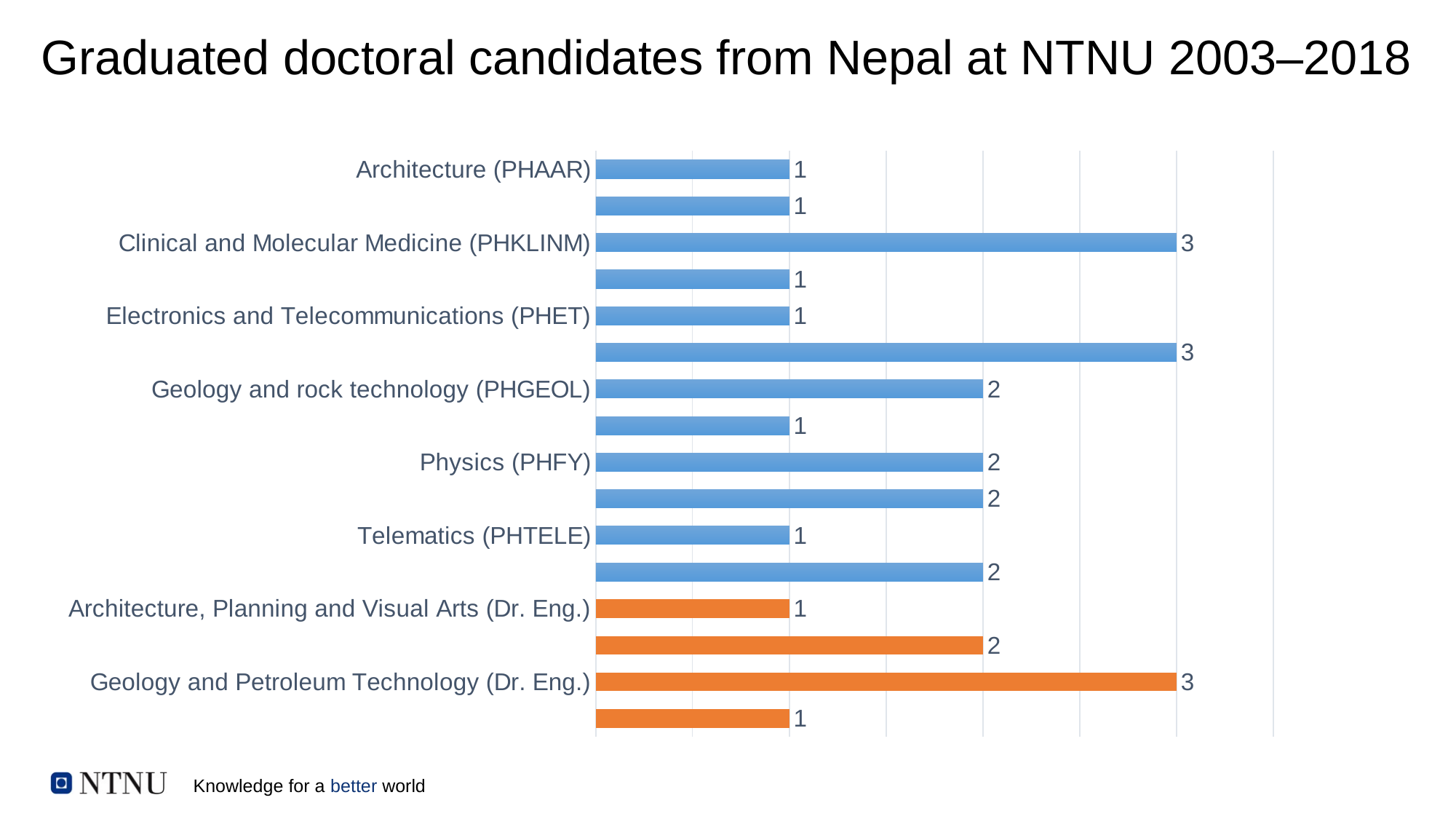
What is the difference between the values for Clinical and Molecular Medicine (PHKLINM) and Architecture (PHAAR)? 2 What is the value for Clinical and Molecular Medicine (PHKLINM)? 3 Which has the larger value, Physics (PHFY) or Telematics (PHTELE)? Physics (PHFY) What kind of chart is shown on the slide? Bar chart What is the value for Geology and rock technology (PHGEOL)? 2 What colour are the bars for the Dr. Eng. categories? Orange How many bars are plotted in the chart? 16 Which has the larger value, Geology and Petroleum Technology (Dr. Eng.) or Architecture, Planning and Visual Arts (Dr. Eng.)? Geology and Petroleum Technology (Dr. Eng.) What is the value for Telematics (PHTELE)? 1 What is the value for Physics (PHFY)? 2 What is the title of the slide? Graduated doctoral candidates from Nepal at NTNU 2003–2018 What is the value for Geology and Petroleum Technology (Dr. Eng.)? 3